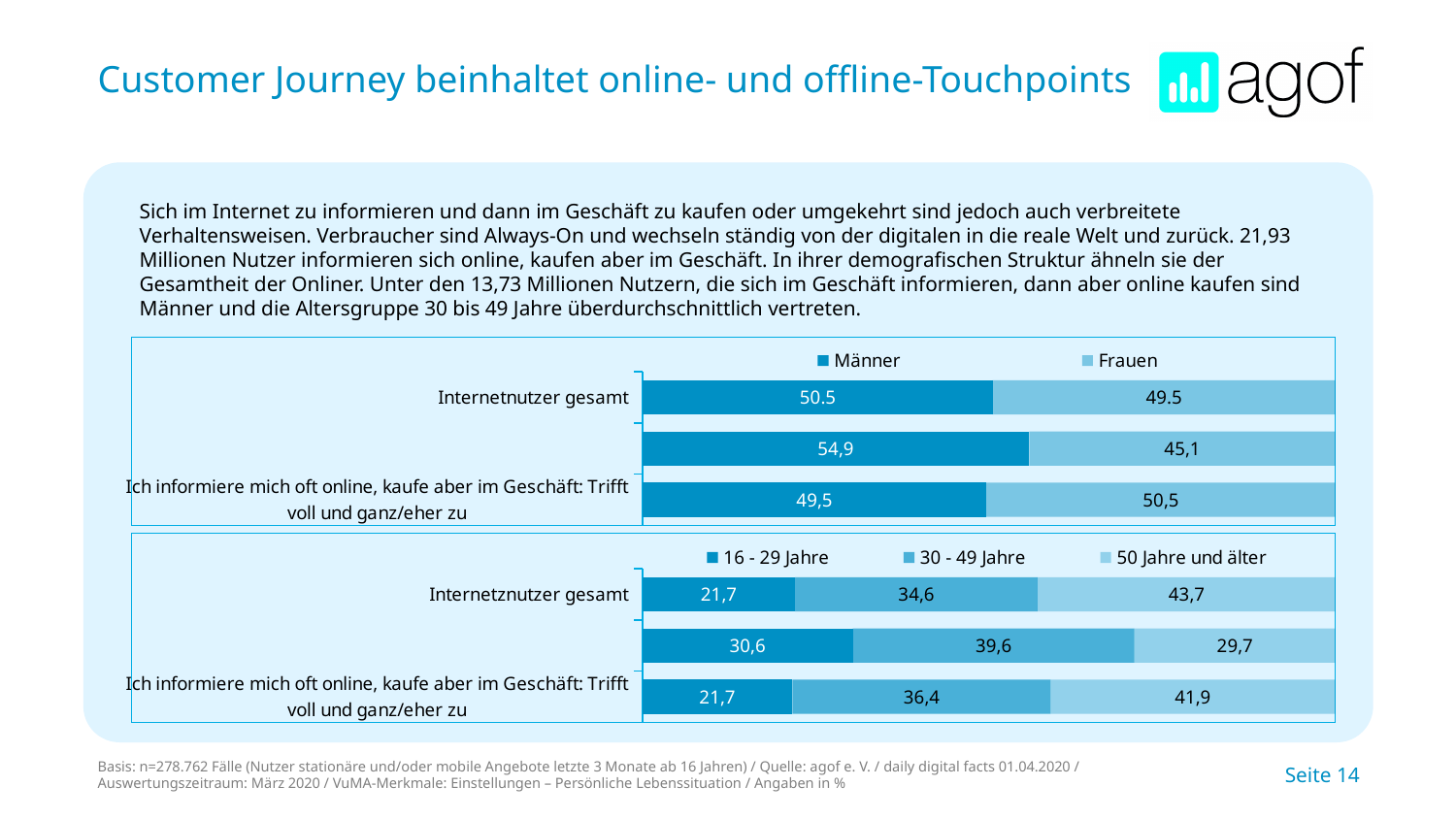
How many series does the legend of the bottom chart list? 3 How many series does the legend of the top chart list? 2 In the bottom chart, what is the total of the Internetznutzer gesamt bar? 100 What kind of chart is the top chart? Stacked bar chart In the bottom chart, which age group has the lowest value in the bar 'Ich informiere mich oft online, kaufe aber im Geschäft: Trifft voll und ganz/eher zu'? 16 - 29 Jahre In the bottom chart, which age group has the highest value in the Internetznutzer gesamt bar? 50 Jahre und älter In the top chart, which is larger in the Internetnutzer gesamt bar: Männer or Frauen? Männer In the bottom chart, what is the value for 30 - 49 Jahre in the bar 'Ich informiere mich oft online, kaufe aber im Geschäft: Trifft voll und ganz/eher zu'? 36,4 In the bottom chart, what is the difference between the 50 Jahre und älter value and the 16 - 29 Jahre value in the Internetznutzer gesamt bar? 22,0 In the bottom chart, what is the value for 50 Jahre und älter in the Internetznutzer gesamt bar? 43,7 In the top chart, what is the value for Männer in the Internetnutzer gesamt bar? 50.5 In the top chart, what is the value for Frauen in the bar 'Ich informiere mich oft online, kaufe aber im Geschäft: Trifft voll und ganz/eher zu'? 50,5